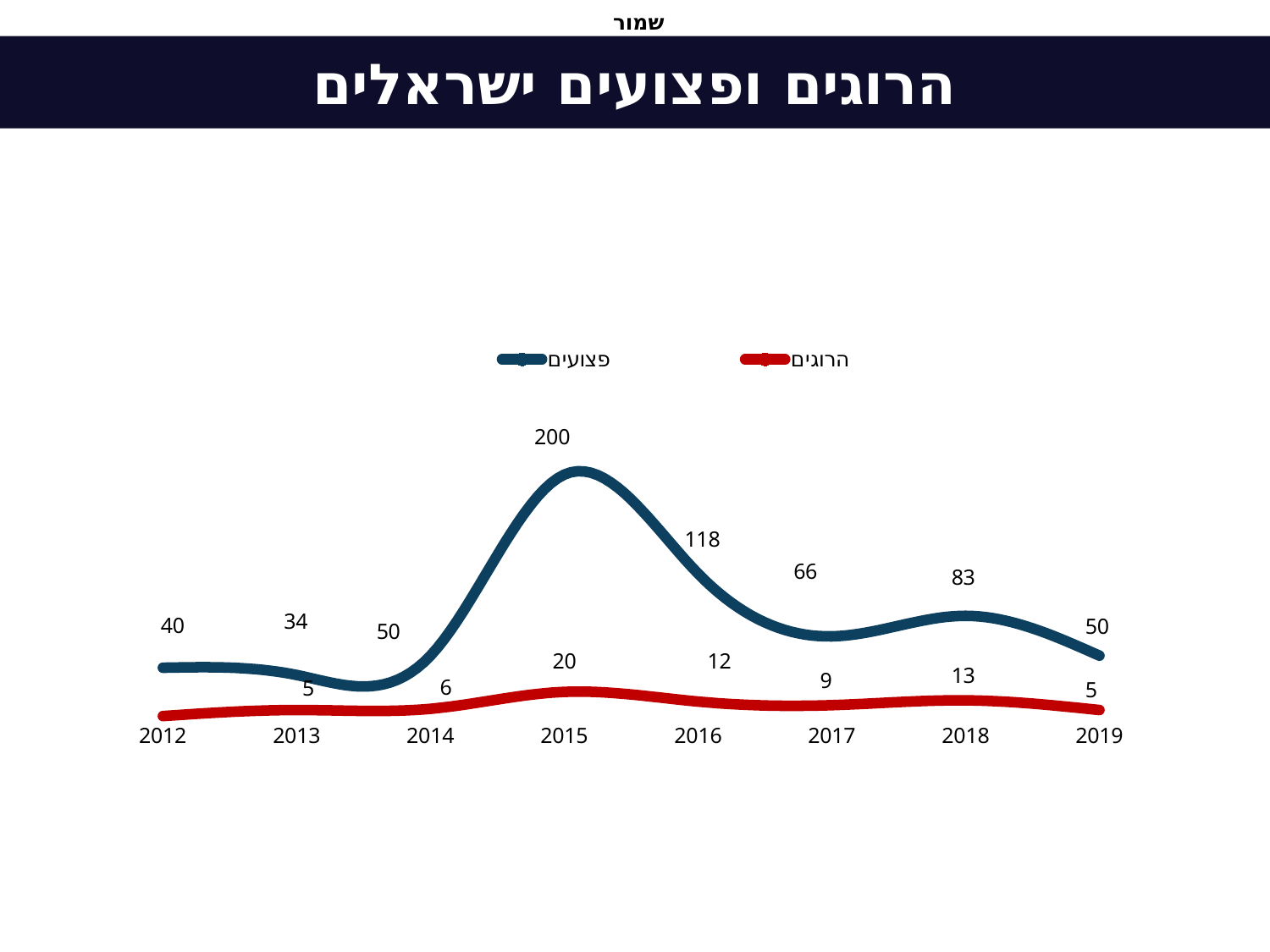
What is the difference between the פצועים values in 2015 and 2016? 82 In which year is the פצועים series highest? 2015 What is the title of the slide's chart? הרוגים ופצועים ישראלים How many years are shown on the x axis? 8 What is the value for פצועים in 2015? 200 In which year is the פצועים series lowest? 2013 Which is larger, the פצועים value in 2017 or in 2018? 2018 How many series does the legend list? 2 What is the value for הרוגים in 2018? 13 What is the value for פצועים in 2016? 118 What kind of chart is shown on the slide? Line chart What is the difference between the הרוגים values in 2015 and 2019? 15